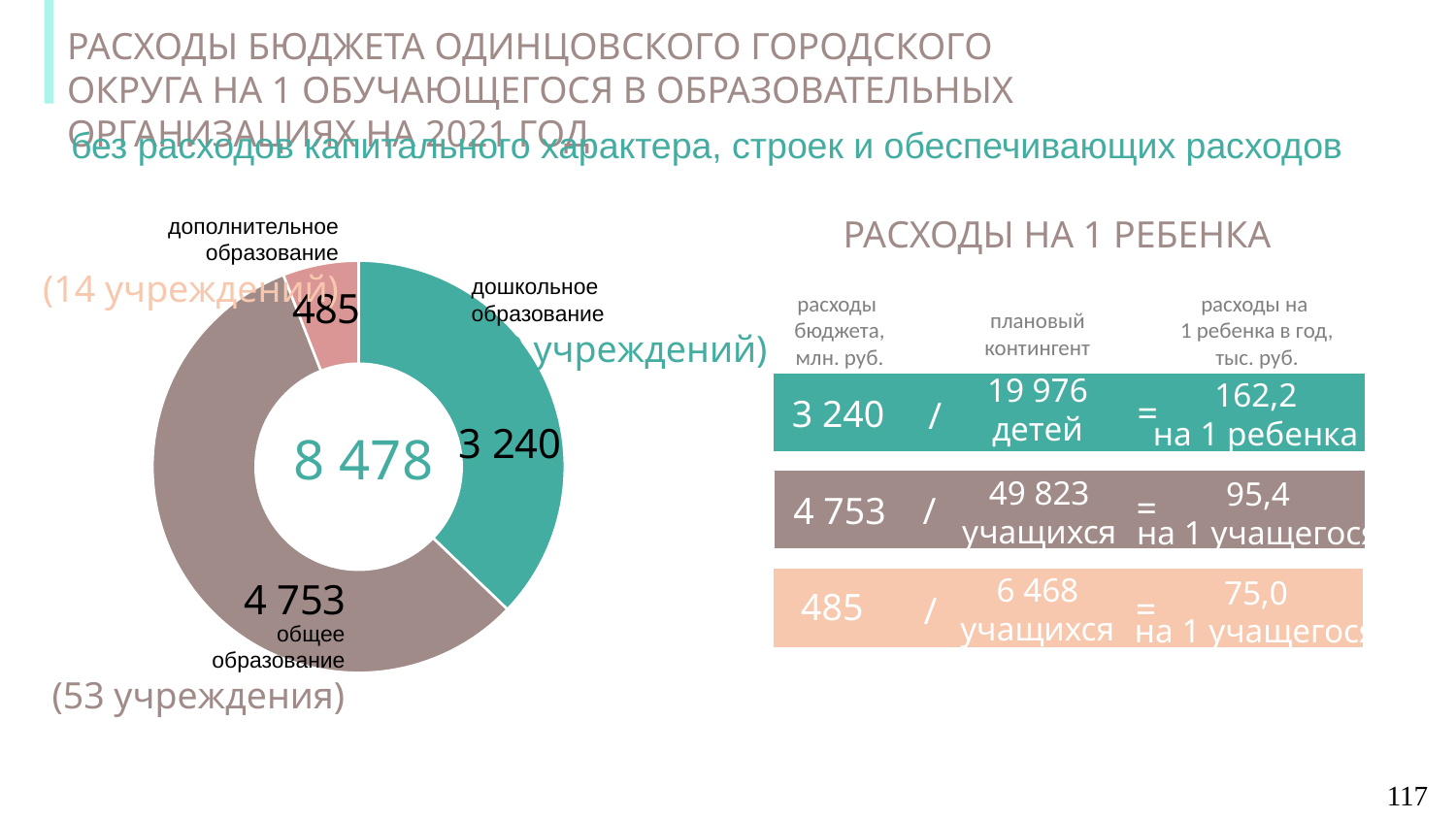
What is the value for "дошкольное образование" in the donut chart? 3 240 What type of chart is shown on the left of the slide? Donut (pie) chart What is the value for "общее образование" in the donut chart? 4 753 What is the difference between the values for "общее образование" and "дошкольное образование" in the donut chart? 1 513 What is the total shown in the centre of the donut chart? 8 478 How many institutions are indicated for "общее образование" next to the donut chart? 53 учреждения Which segment of the donut chart has the largest value? общее образование Which segment of the donut chart has the smallest value? дополнительное образование What colour is the "общее образование" segment of the donut chart? Brownish grey What is the value for "дополнительное образование" in the donut chart? 485 Which is larger in the donut chart: "дошкольное образование" or "дополнительное образование"? дошкольное образование How many segments does the donut chart have? 3